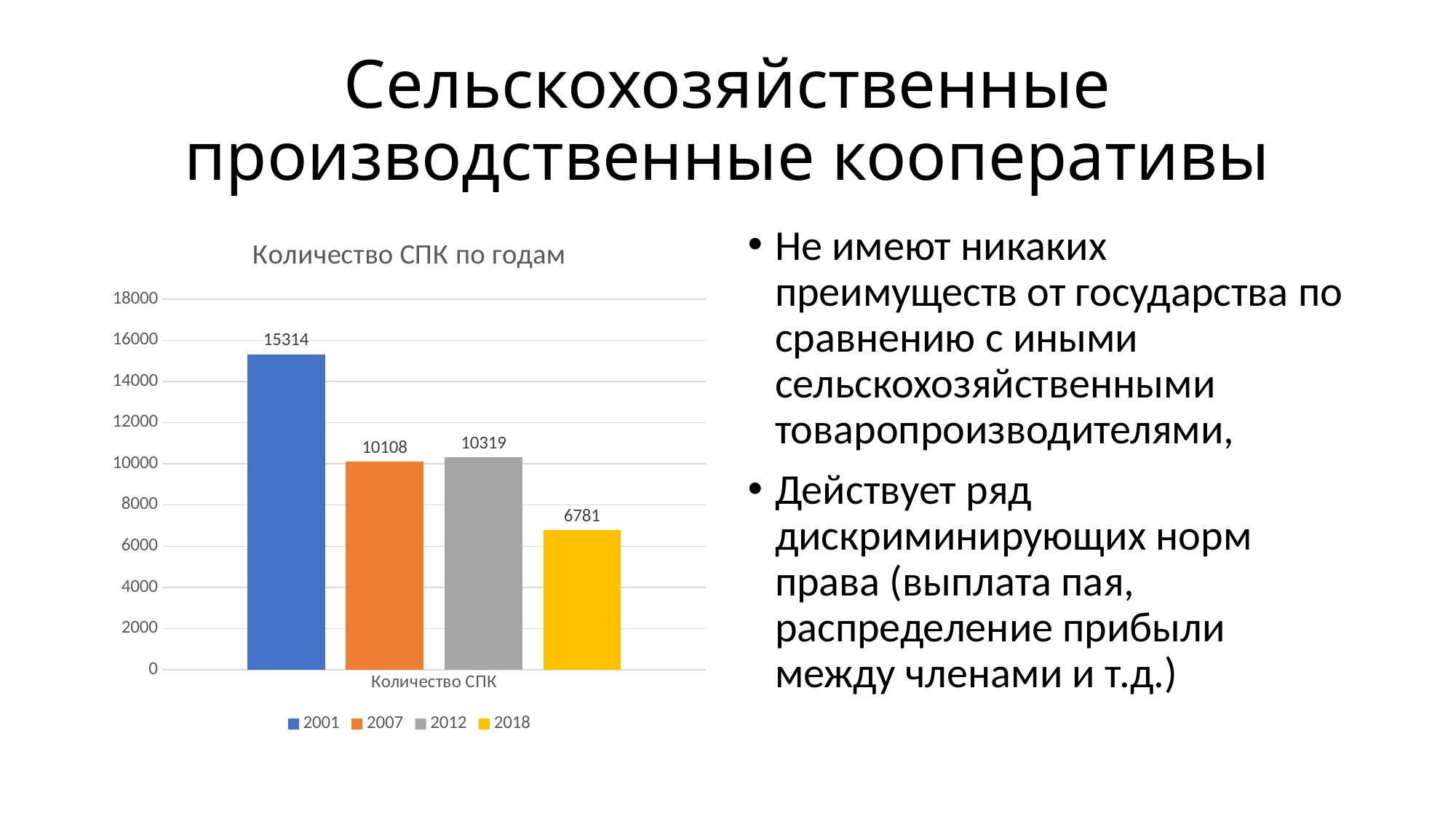
What is the value for 2018 in the chart? 6781 What is the difference between the values for 2001 and 2018? 8533 How many series does the legend list? 4 What is the value for 2001 in the chart? 15314 Which year has the lowest value in the chart? 2018 What is the value for 2007 in the chart? 10108 What is the value for 2012 in the chart? 10319 What is the title of the chart? Количество СПК по годам What kind of chart is shown on the slide? bar chart Which is larger, the value for 2001 or the value for 2012? 2001 What is the difference between the values for 2012 and 2007? 211 Which year has the highest value in the chart? 2001